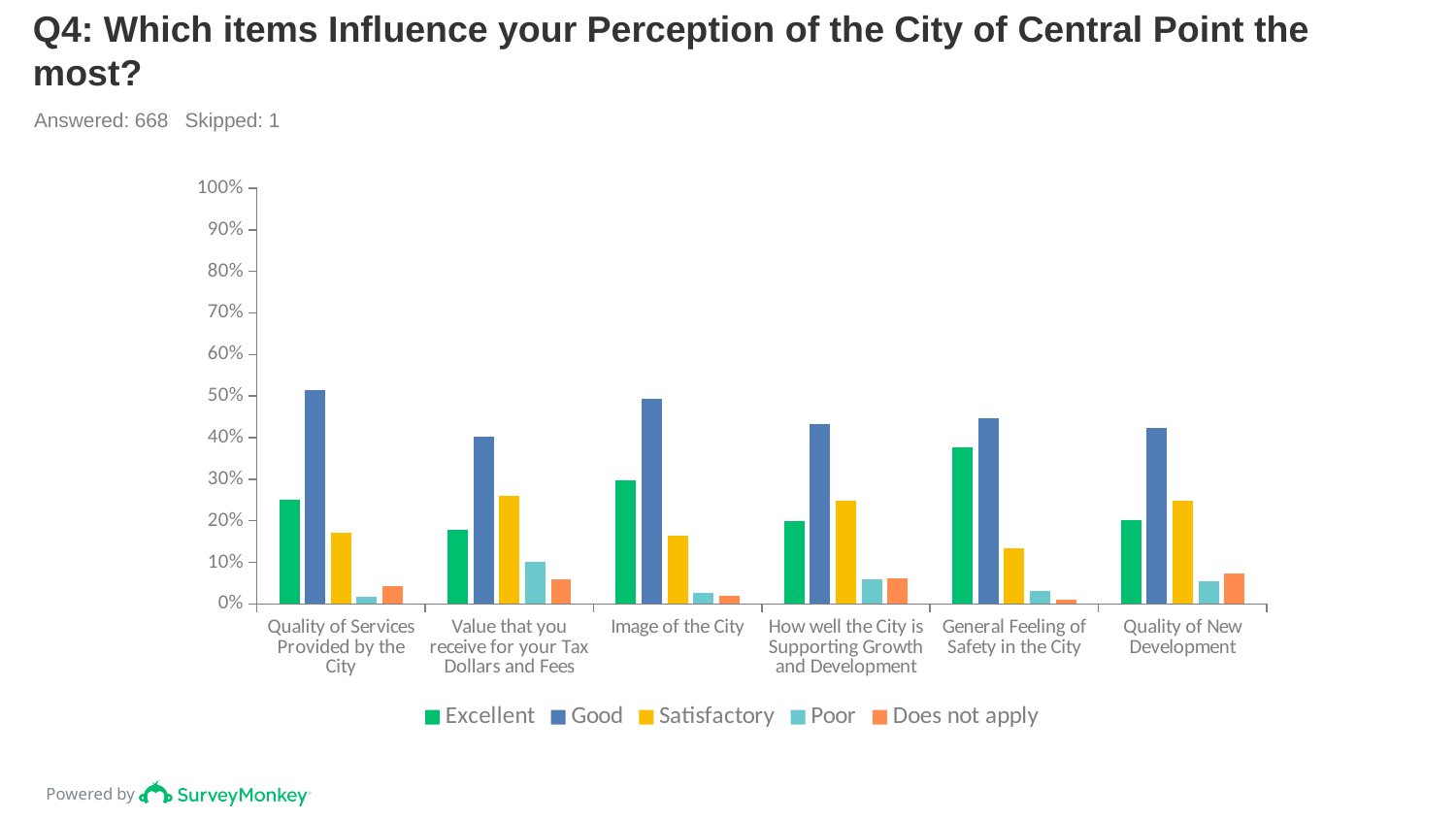
For Quality of Services Provided by the City, which is larger: the Excellent value or the Satisfactory value? Excellent Which category has the lowest Satisfactory value? General Feeling of Safety in the City For General Feeling of Safety in the City, which is larger: the Excellent value or the Good value? Good How many categories are shown along the x axis of the chart? 6 Is the Excellent value for Image of the City greater or less than 20%? greater What kind of chart is shown on the slide? bar chart Is the Satisfactory value for General Feeling of Safety in the City greater or less than 20%? less Is the Good value for Quality of Services Provided by the City greater or less than 40%? greater How many series does the chart's legend list? 5 Which series is the tallest bar in every category of the chart? Good Which category has the highest Excellent value? General Feeling of Safety in the City Which category has the highest Poor value? Value that you receive for your Tax Dollars and Fees